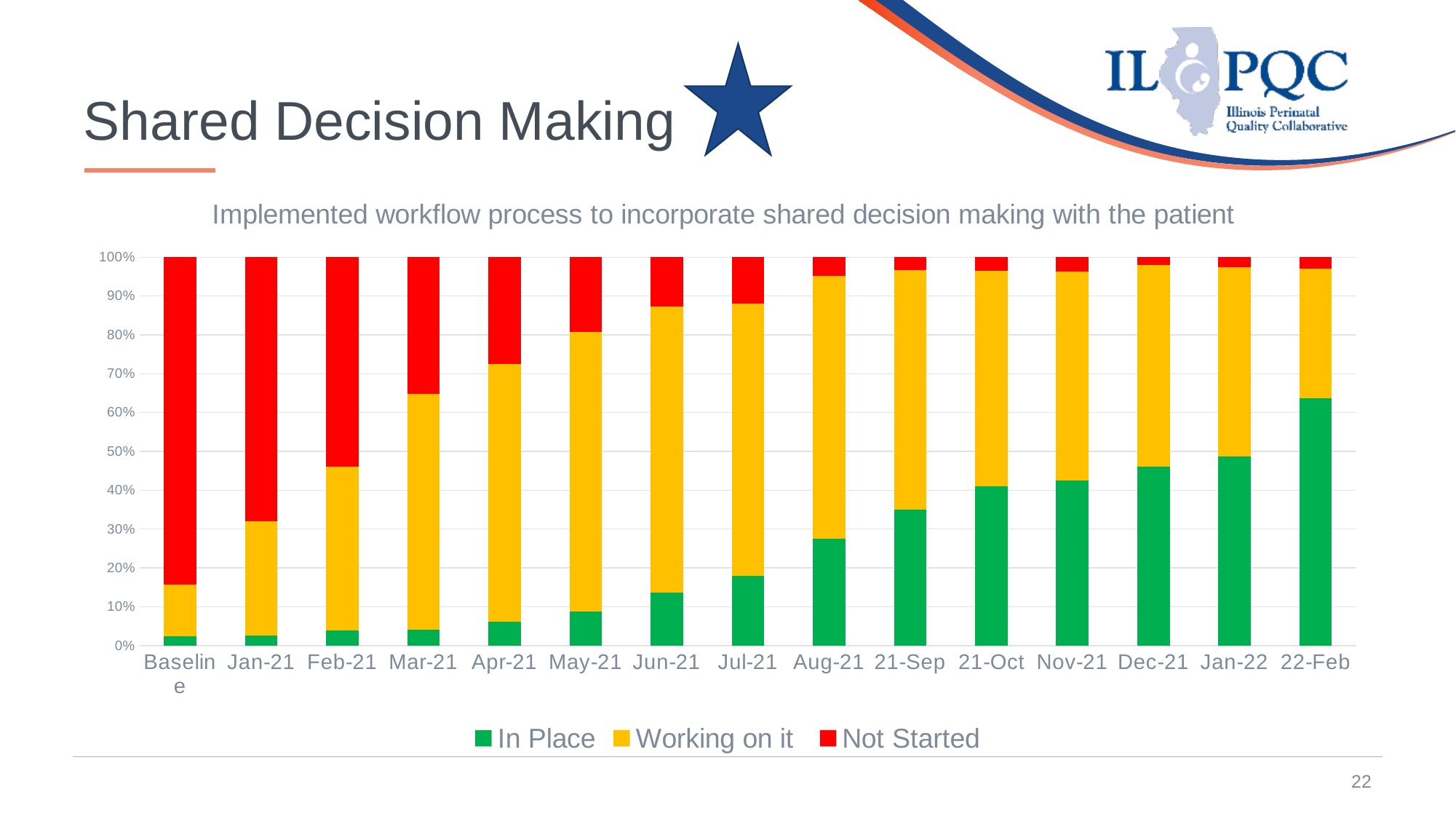
Does the 'Not Started' share rise or fall from Baseline to 22-Feb? Fall How many series does the chart's legend list? 3 In which period is the 'Not Started' share the highest? Baseline What kind of chart is shown on the slide? Stacked bar chart Is the 'Not Started' value for Baseline greater or less than 80%? greater Is the 'In Place' value for 22-Feb greater or less than 50%? greater Which is larger, the 'In Place' share for 22-Feb or for Jan-22? 22-Feb Which series is shown in red in the chart? Not Started In which period is the 'In Place' share the highest? 22-Feb Does the 'In Place' share rise or fall from Baseline to 22-Feb? Rise How many time periods (categories) are shown along the x axis of the chart? 15 What is the title of the chart? Implemented workflow process to incorporate shared decision making with the patient